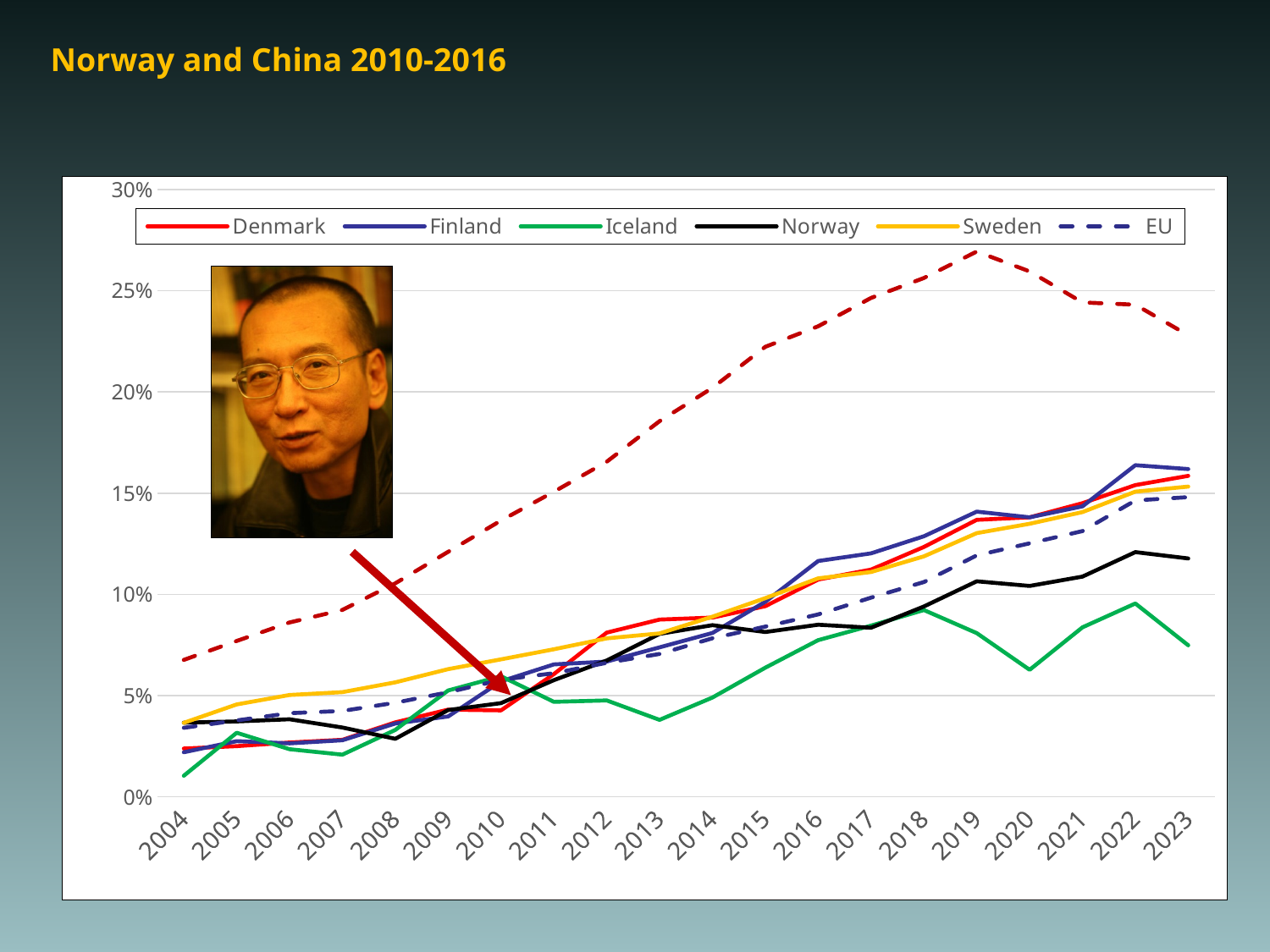
How many series does the chart's legend list? 6 Is the value for Norway in 2023 greater or less than 15%? less Is the value for Iceland in 2004 greater or less than 5%? less Is the value for Finland in 2022 greater or less than 15%? greater Does the Norway line generally rise or fall from 2004 to 2023? rise What kind of chart is shown on the slide? line chart Which of the legend series has the lowest value in 2023? Iceland In 2020, which is larger, the value for Iceland or the value for Sweden? Sweden In 2023, which is larger, the value for Finland or the value for Norway? Finland How many years are shown along the x axis of the chart? 20 Which legend entry is drawn with a dashed line? EU